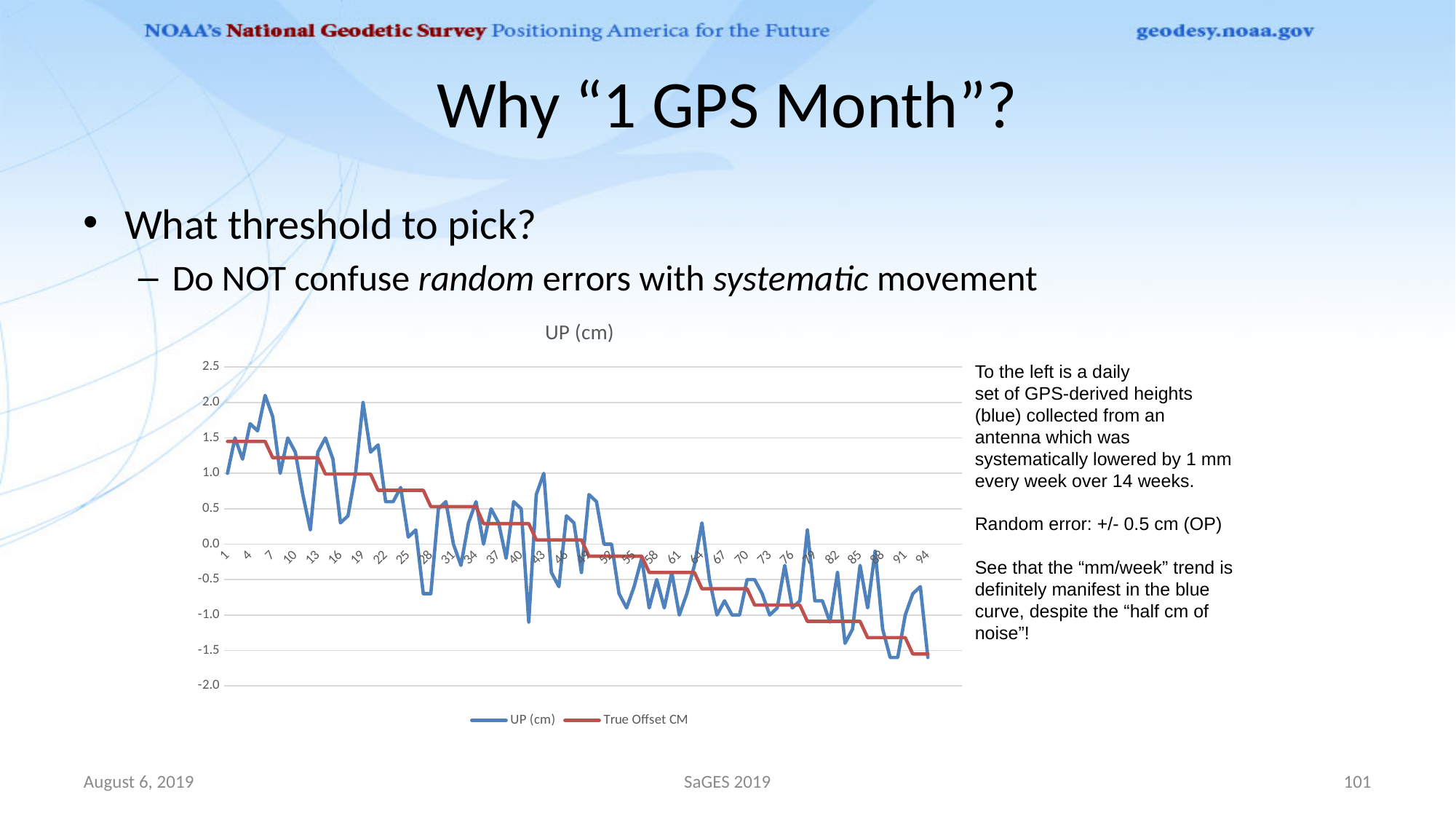
What is the title of the chart? UP (cm) Is the lowest value of the UP (cm) series greater or less than -1.0? less Overall, do the values of the UP (cm) series rise or fall along the x axis? fall How many series does the chart legend list? 2 Do the values of the True Offset CM series rise or fall along the x axis? fall Which series is drawn in red according to the legend? True Offset CM Is the value of the True Offset CM series at x = 43 greater or less than 0.5? less Is the value of the True Offset CM series at x = 1 greater or less than 1.0? greater What is the highest value shown on the y axis? 2.5 What kind of chart is shown on the slide? line chart